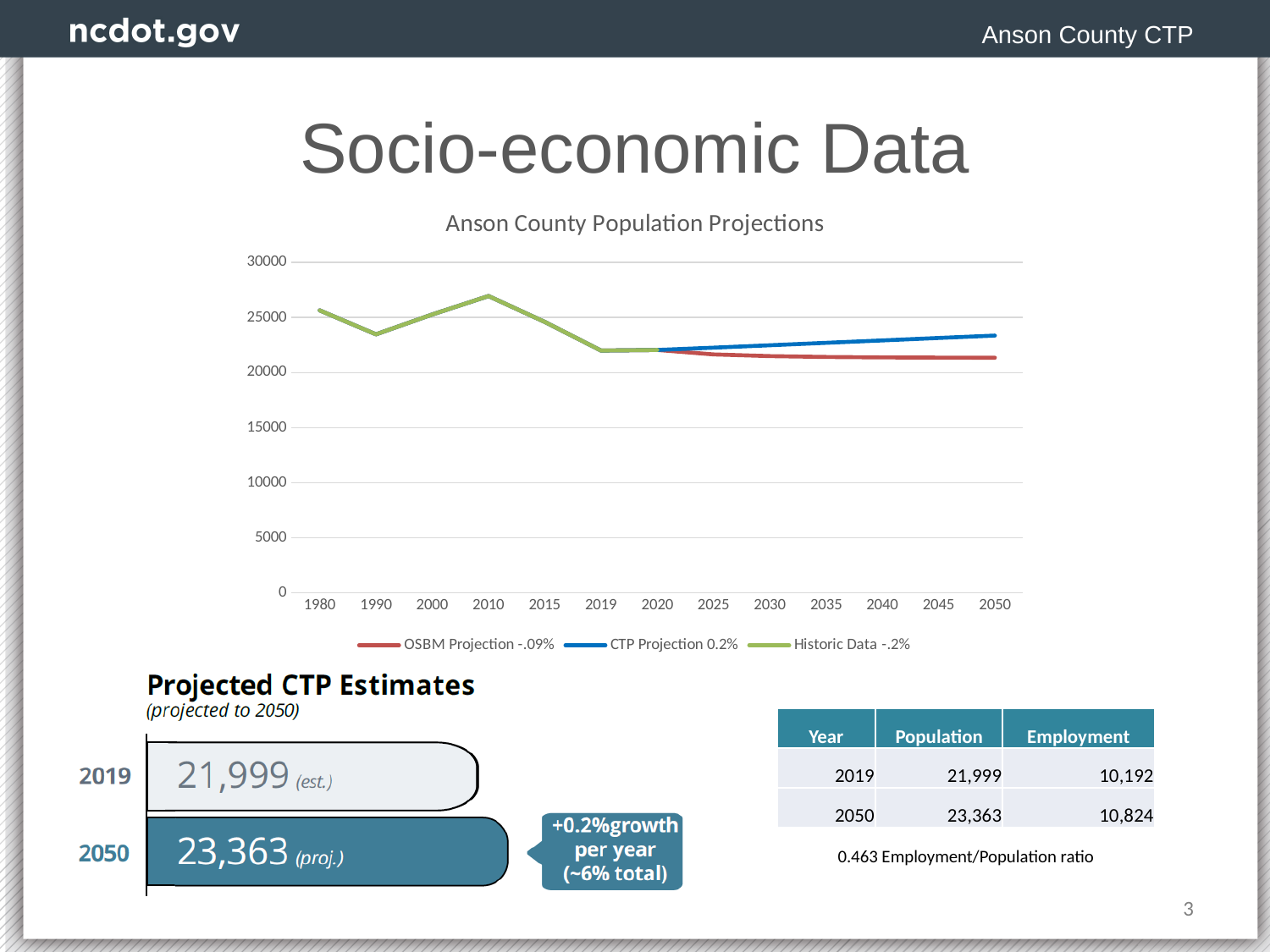
How many series does the chart legend list? 3 Which series in the legend is drawn in green? Historic Data -.2% How many year labels are shown along the x axis of the chart? 13 What is the title of the chart? Anson County Population Projections Is the OSBM Projection value for 2050 greater or less than 25000? less Is the CTP Projection value for 2050 greater or less than 20000? greater Is the Historic Data value for 2010 greater or less than 25000? greater In which year does the Historic Data series reach its highest value? 2010 At 2050, which series is higher: the CTP Projection or the OSBM Projection? CTP Projection What kind of chart is shown on the slide? line chart Does the CTP Projection series rise or fall from 2020 to 2050? rise